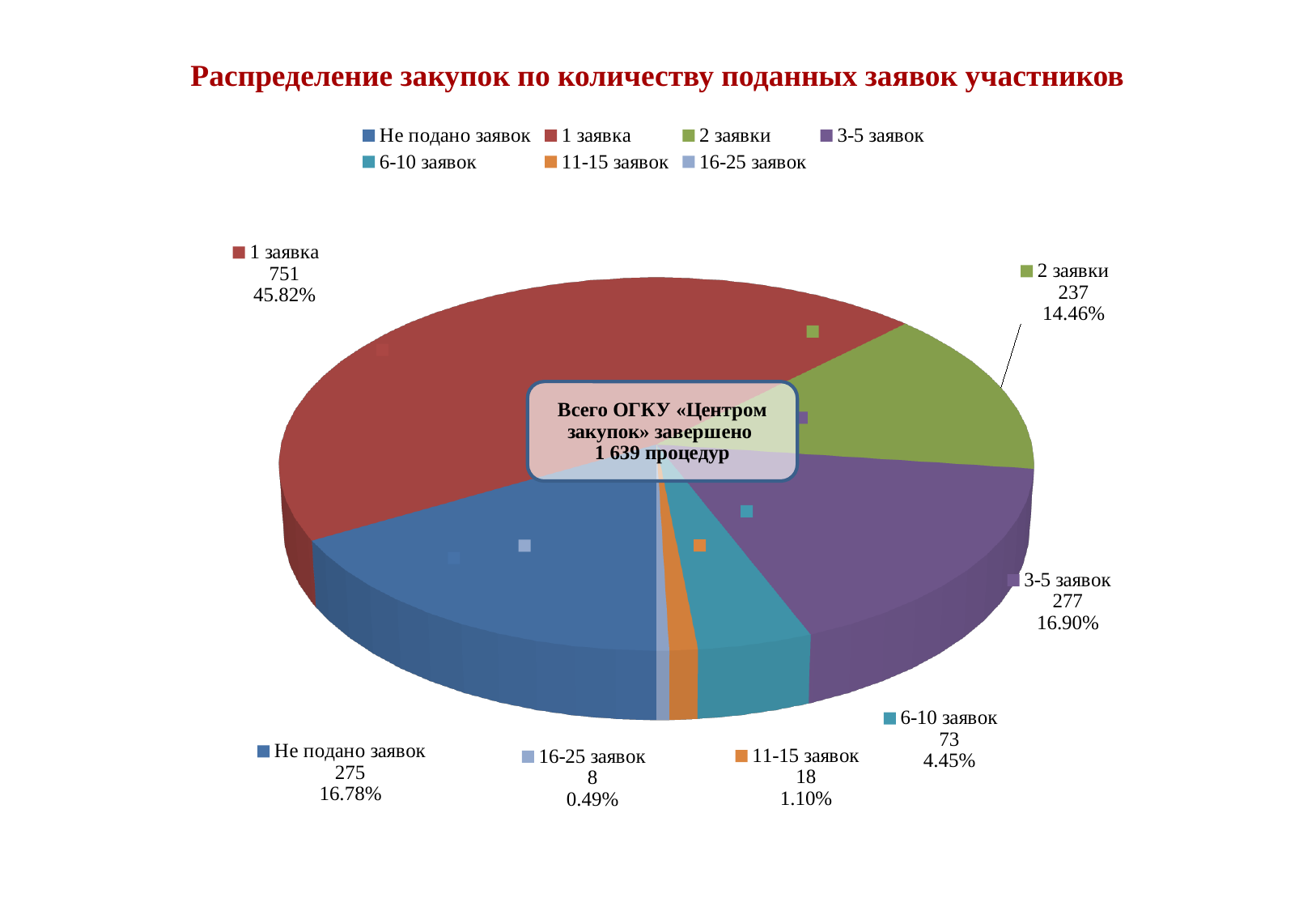
What share of the pie does "2 заявки" represent? 14.46% What is the title of the chart? Распределение закупок по количеству поданных заявок участников How many categories does the pie chart have? 7 What is the value for "3-5 заявок"? 277 What is the value for "1 заявка"? 751 Which category has the largest slice? 1 заявка What share of the pie does "Не подано заявок" represent? 16.78% What is the difference between the values for "1 заявка" and "2 заявки"? 514 Which category has the smallest slice? 16-25 заявок What type of chart is shown on the slide? Pie chart Which is larger, the value for "6-10 заявок" or the value for "11-15 заявок"? 6-10 заявок What is the total number of procedures stated in the centre of the chart? 1 639 процедур